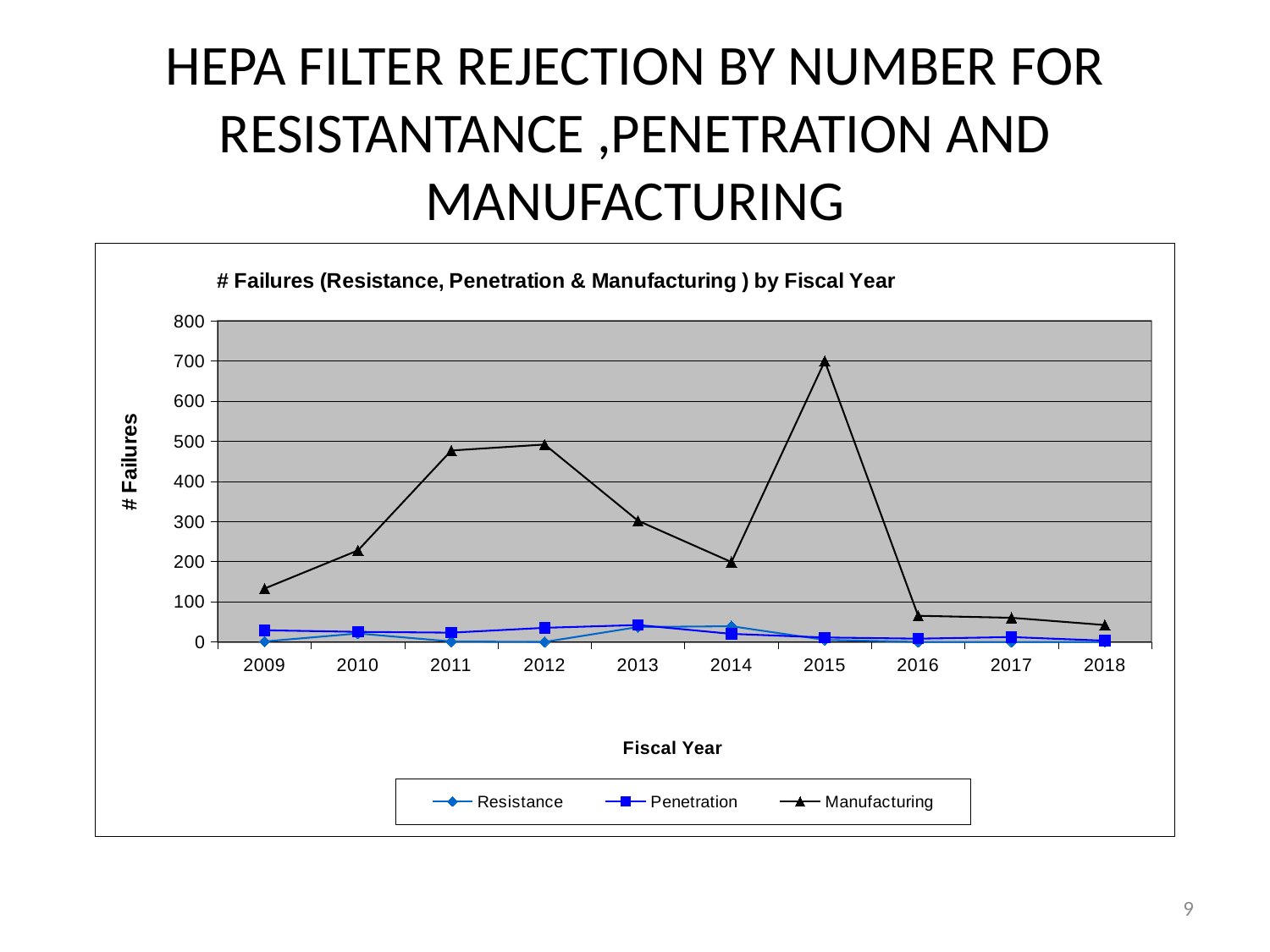
How many series does the legend list? 3 What is the label on the y axis of the chart? # Failures In which fiscal year does the Manufacturing series reach its highest value? 2015 Which is larger for the Manufacturing series: the value for 2013 or the value for 2014? 2013 How many fiscal years are plotted along the x axis? 10 Does the Manufacturing series rise or fall from 2015 to 2018? Fall What kind of chart is shown on the slide? Line chart What is the label on the x axis of the chart? Fiscal Year Is the Manufacturing value for 2016 greater or less than 100? less Is the Manufacturing value for 2013 greater or less than 400? less Is the Manufacturing value for 2011 greater or less than 400? greater